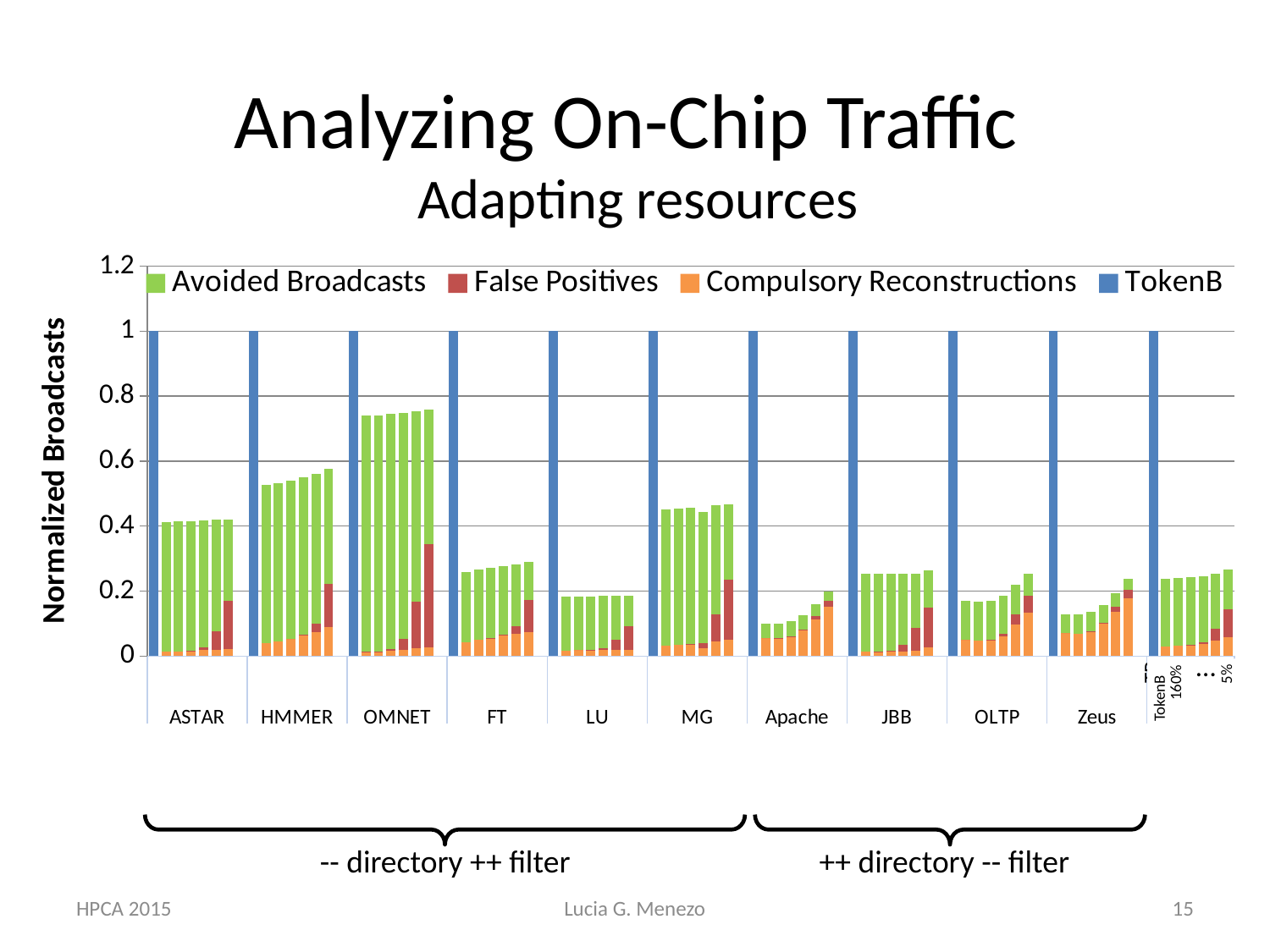
How many series does the chart legend list? 4 Which benchmark has the highest stacked (non-TokenB) bars? OMNET Within the Zeus group, do the stacked bars rise or fall from left to right? rise Is the value of the stacked bars for OMNET greater or less than 0.6? greater Which benchmark has larger stacked (non-TokenB) bars, OMNET or ASTAR? OMNET Is the value of the stacked bars for HMMER greater or less than 0.4? greater What kind of chart is shown on the slide? Stacked bar chart What is the normalized broadcasts value of the TokenB bar for ASTAR? 1 Is the value of the stacked bars for MG greater or less than 0.6? less What is the title of the y axis of the chart? Normalized Broadcasts How many benchmark groups are labelled along the x axis of the chart? 10